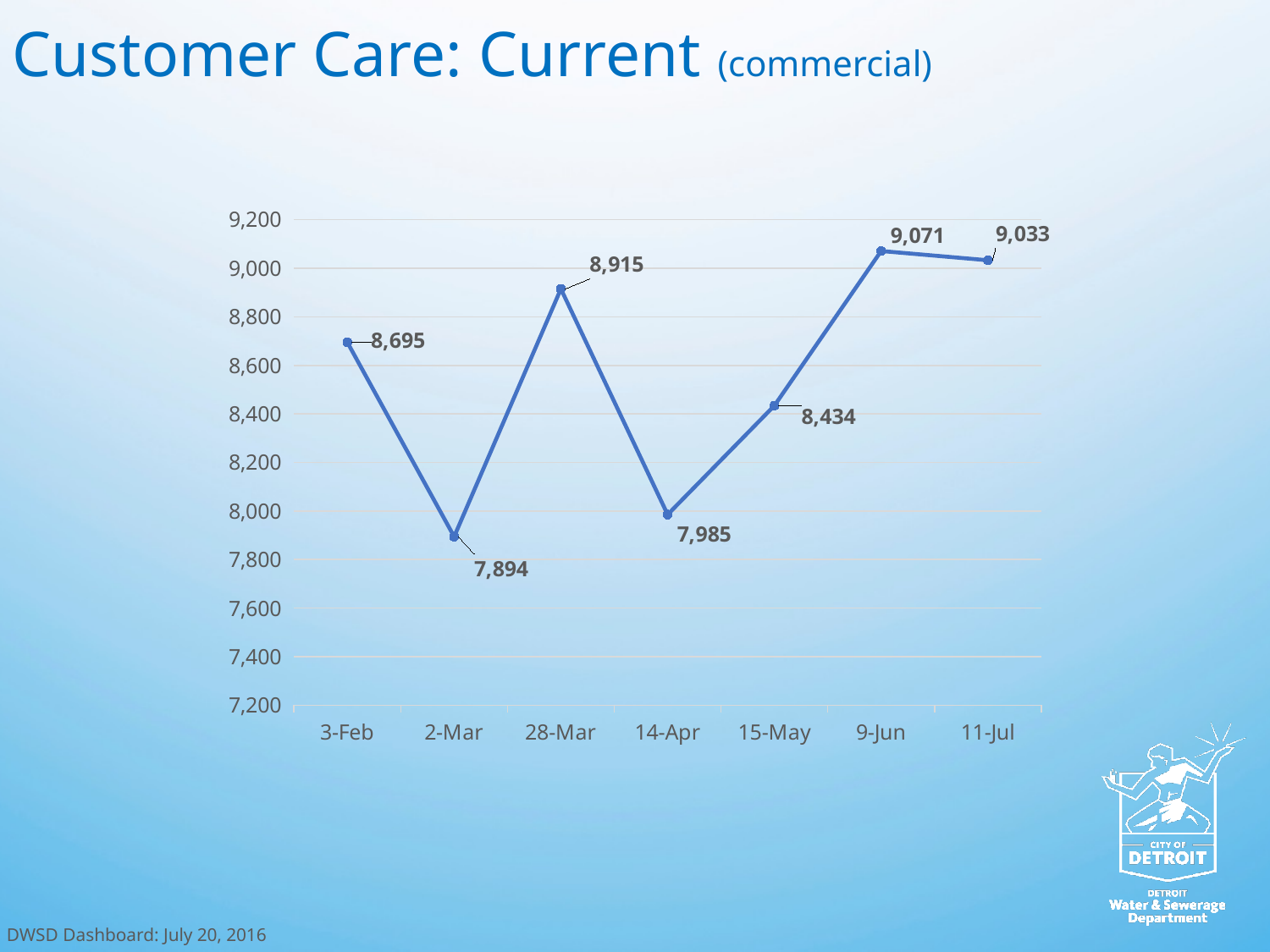
Is the value for 14-Apr greater or less than 8,000? less Which date has the lowest value? 2-Mar How many data points are plotted on the chart? 7 Which is larger, the value for 3-Feb or the value for 15-May? 3-Feb What is the difference between the values for 9-Jun and 15-May? 637 What is the value for 11-Jul? 9,033 Which date has the highest value? 9-Jun What is the value for 14-Apr? 7,985 What is the value for 3-Feb? 8,695 What kind of chart is shown on the slide? line chart Does the value rise or fall from 9-Jun to 11-Jul? fall What is the difference between the values for 28-Mar and 2-Mar? 1,021